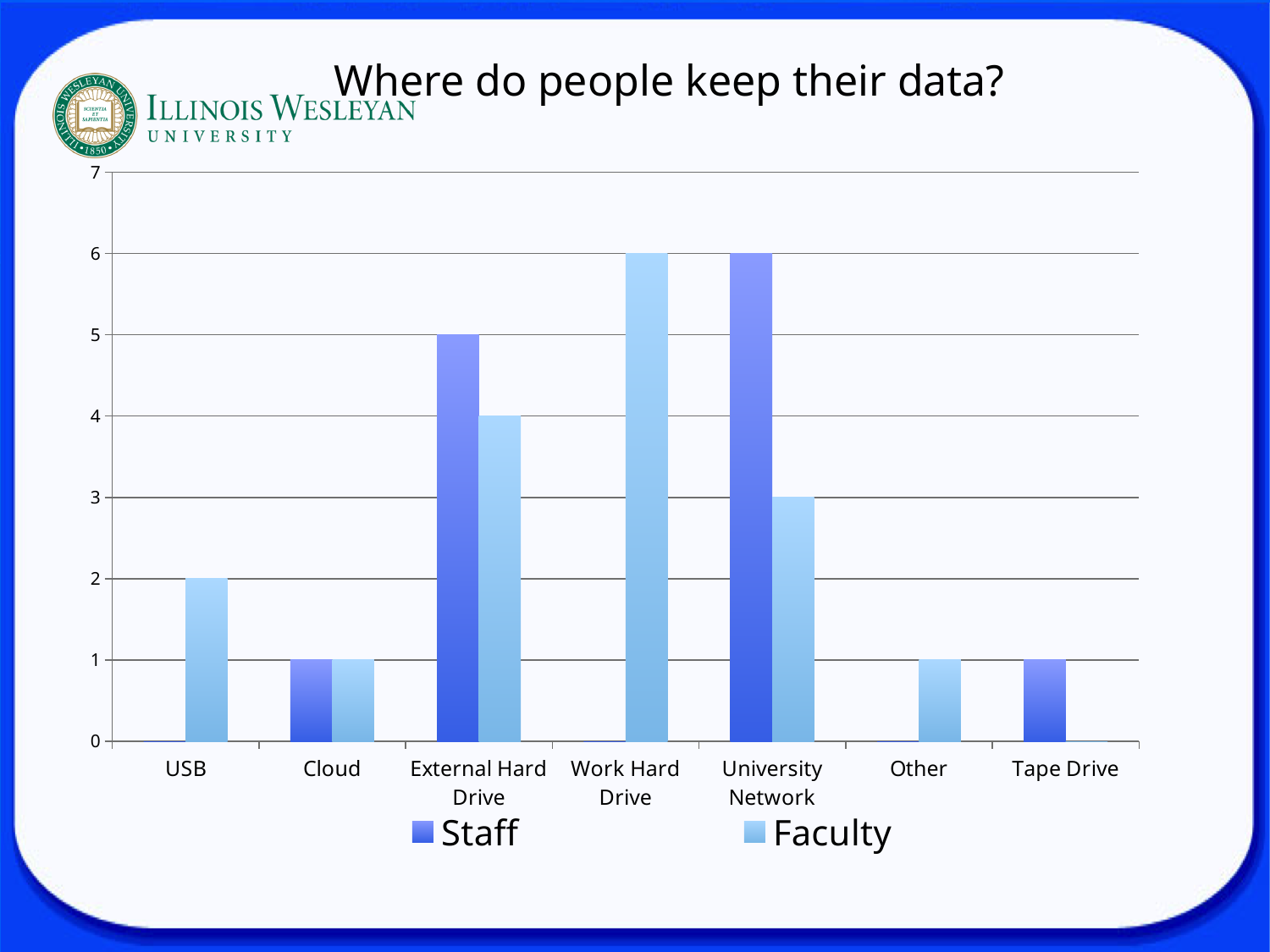
What is the Faculty value for Work Hard Drive? 6 Is the Faculty value for USB greater or less than 4? less What is the Staff value for External Hard Drive? 5 What kind of chart is shown on the slide? bar chart Which category has the highest Faculty value? Work Hard Drive What is the Faculty value for University Network? 3 Which is larger for External Hard Drive, the Staff value or the Faculty value? Staff What is the difference between the Staff and Faculty values for University Network? 3 What is the title of the chart? Where do people keep their data? How many series does the legend list? 2 How many categories are shown on the x axis? 7 Which category has the highest Staff value? University Network